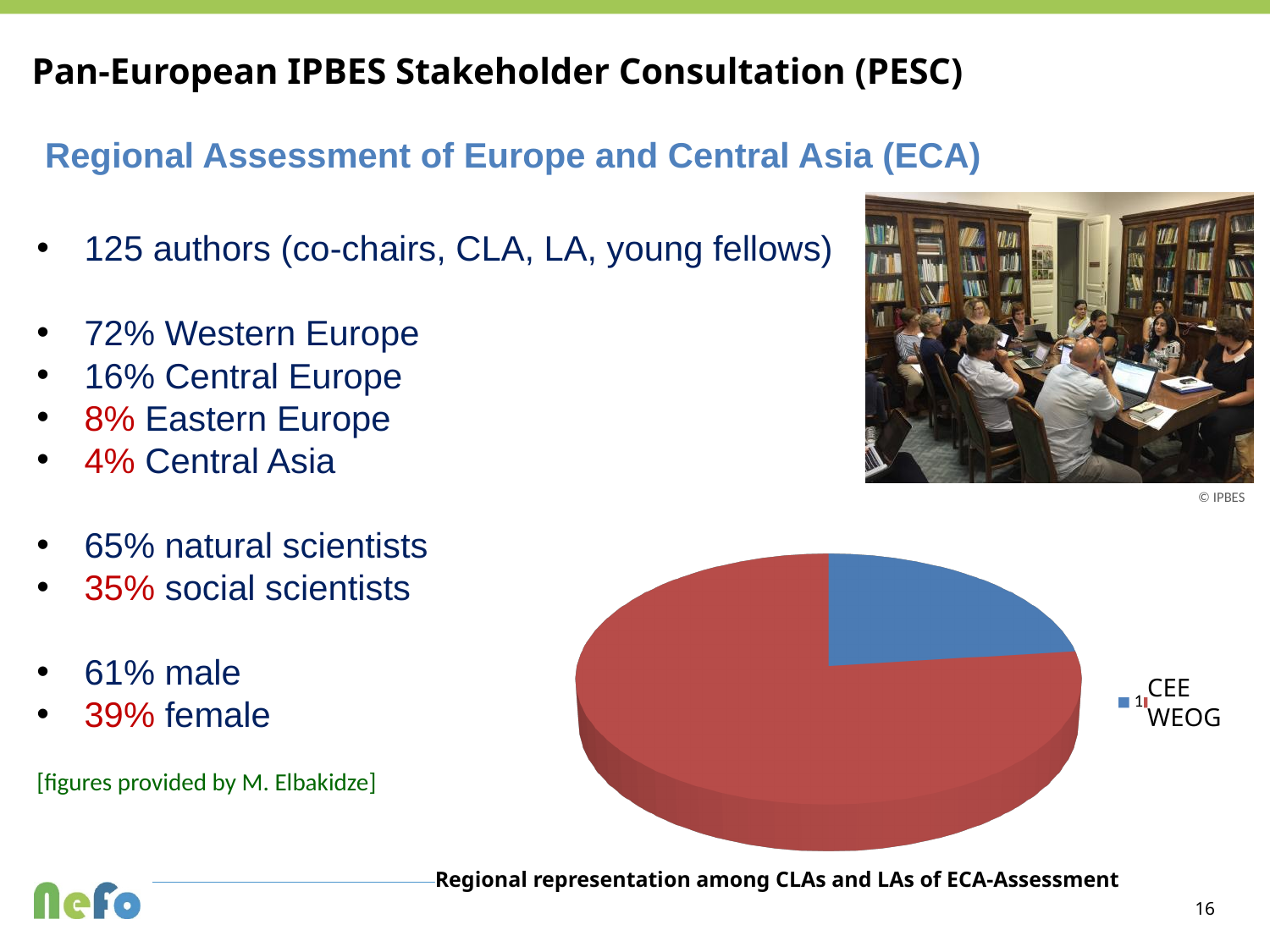
What kind of chart is shown on the slide? pie chart Which category has the largest slice in the pie chart? WEOG How many entries does the legend of the pie chart list? 2 What is the caption printed below the pie chart? Regional representation among CLAs and LAs of ECA-Assessment Which category has the smallest slice in the pie chart? CEE Which slice is larger in the pie chart, CEE or WEOG? WEOG Does the WEOG slice take up more or less than half of the pie chart? more How many slices does the pie chart have? 2 What colour is the WEOG slice in the pie chart? red